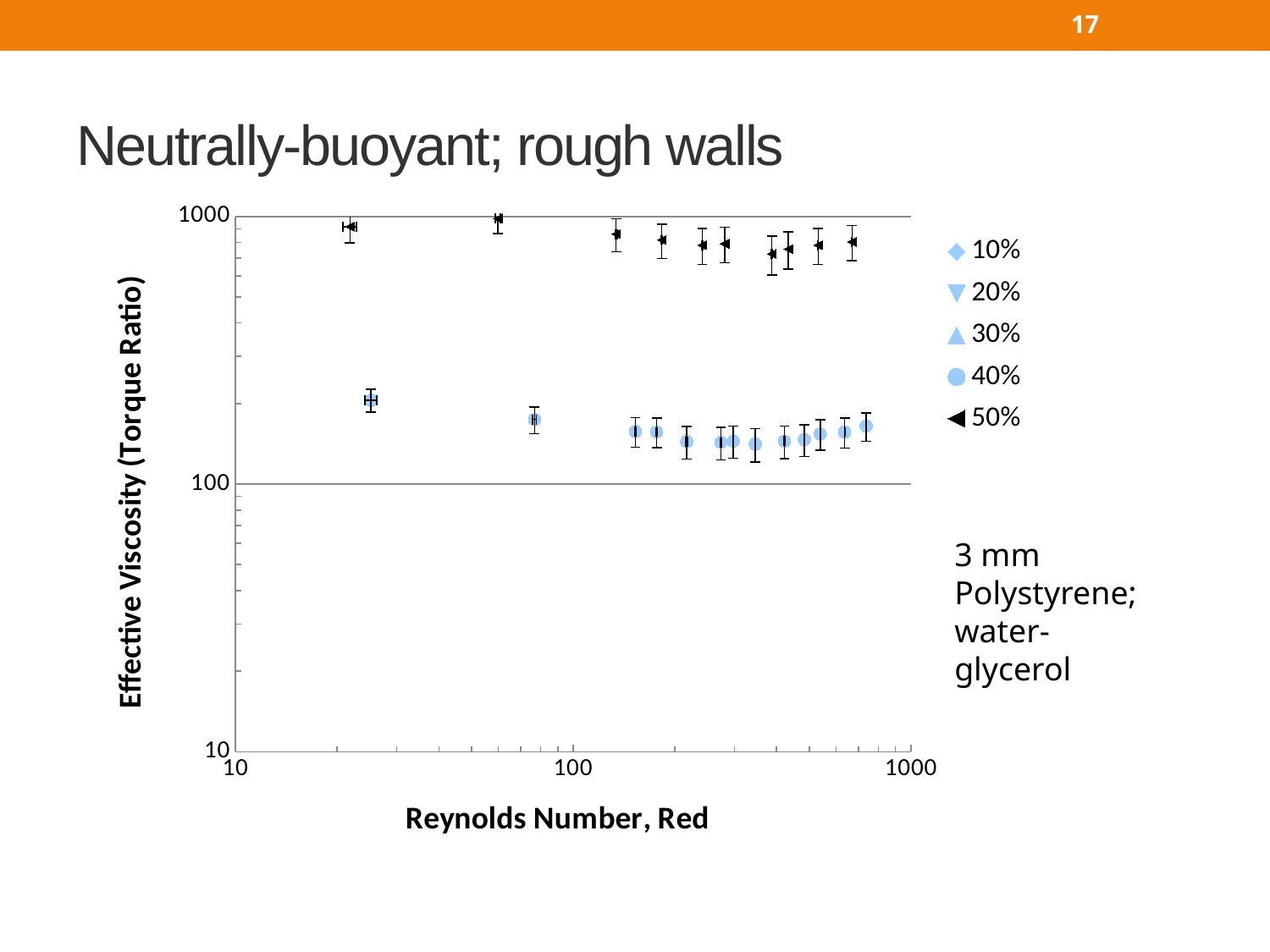
Which series has the higher effective viscosity values, 40% or 50%? 50% Do the effective viscosity values for the 40% series rise or fall as the Reynolds number increases from its lowest value? fall Are the effective viscosity values for the 50% series greater or less than 100? greater Which series has the lowest effective viscosity values on the chart? 40% What is the title of the chart's x axis? Reynolds Number, Red Are the effective viscosity values for the 40% series greater or less than 100? greater Is the effective viscosity for the 50% series at the lowest Reynolds number greater or less than 100? greater How many series does the legend list? 5 Which legend entry is shown with a black left-pointing triangle marker? 50% What kind of chart is shown on the slide? scatter plot What is the title of the chart's y axis? Effective Viscosity (Torque Ratio)